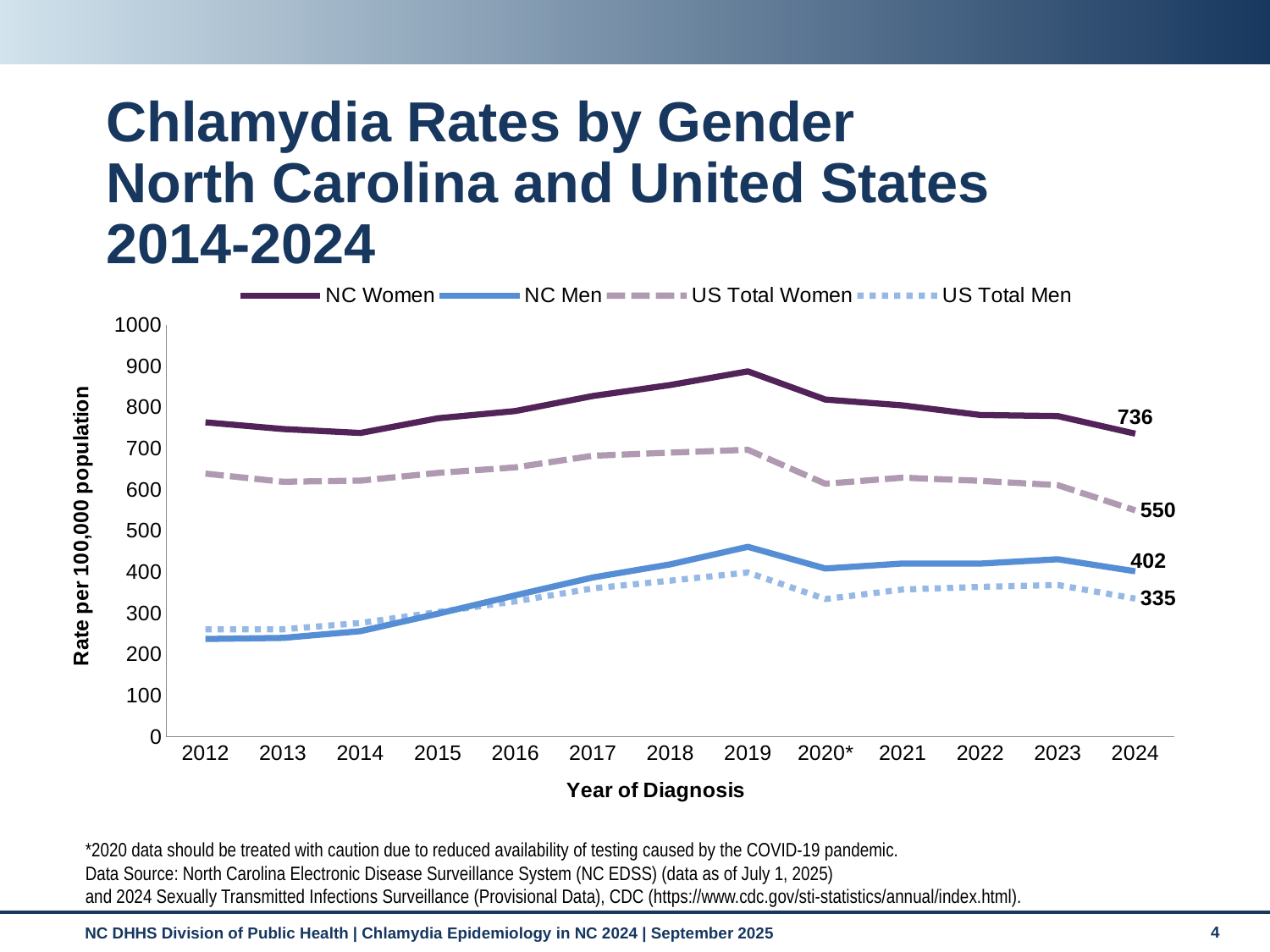
Which series has the highest rate in 2024? NC Women How many series does the legend list? 4 What is the difference between the US Total Women and US Total Men rates in 2024? 215 Is the NC Women rate in 2019 greater or less than 800? greater What is the difference between the NC Women and NC Men rates in 2024? 334 What is the US Total Women rate in 2024? 550 What is the NC Men rate in 2024? 402 What kind of chart is shown on the slide? Line chart What is the NC Women chlamydia rate in 2024? 736 What is the US Total Men rate in 2024? 335 How many years are shown on the x axis? 13 Does the NC Women rate rise or fall from 2019 to 2024? Fall